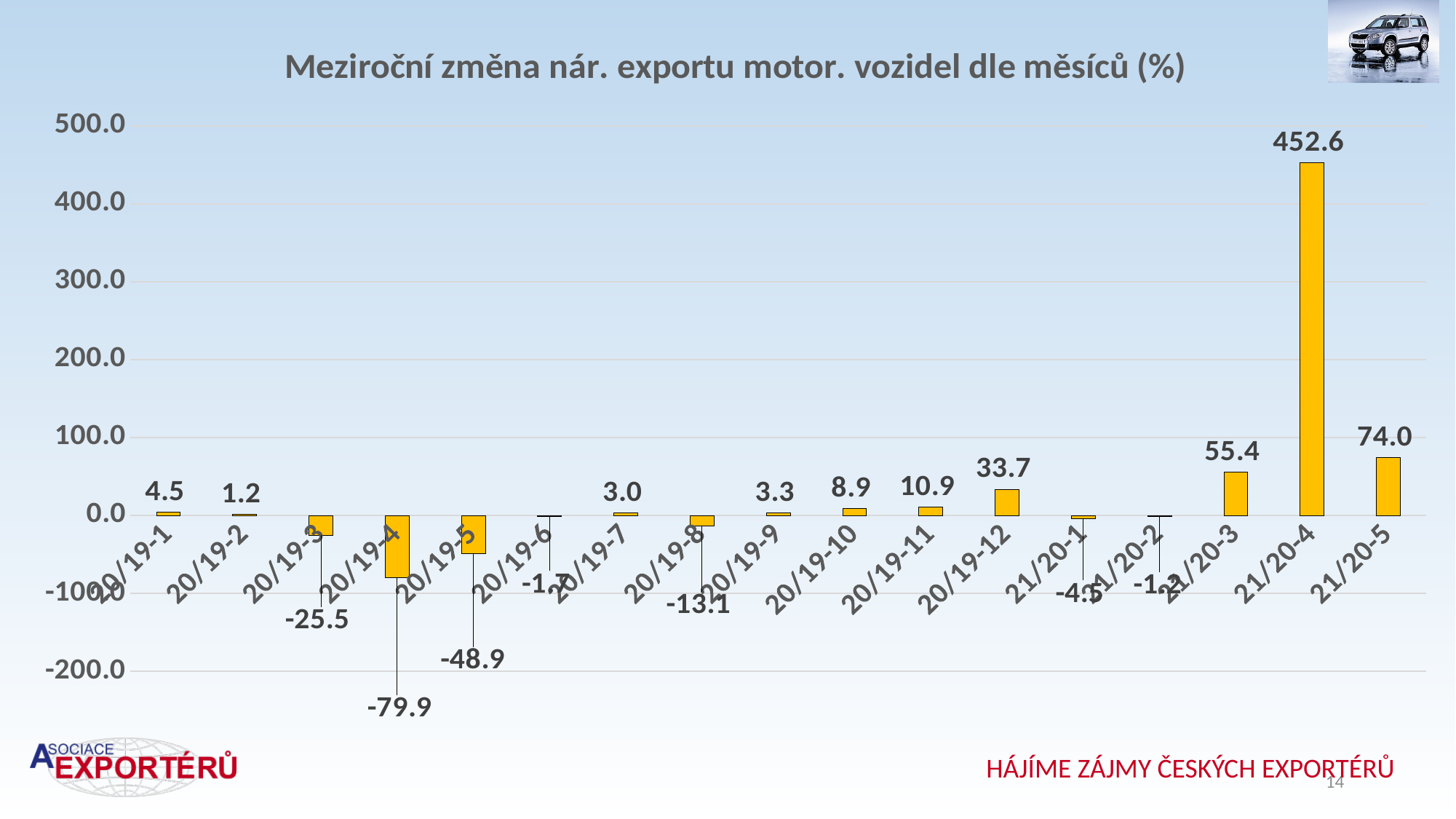
What is the value for 20/19-4? -79.9 Which month has the lowest value in the chart? 20/19-4 What is the title of the chart? Meziroční změna nár. exportu motor. vozidel dle měsíců (%) How many months (categories) are shown on the x axis? 17 What kind of chart is shown on the slide? bar chart Which month has the highest value in the chart? 21/20-4 What is the value for 21/20-4? 452.6 What is the value for 20/19-10? 8.9 What is the value for 20/19-12? 33.7 Which has the larger value, 20/19-3 or 20/19-5? 20/19-3 What is the difference between the values for 21/20-4 and 21/20-5? 378.6 What is the value for 21/20-5? 74.0